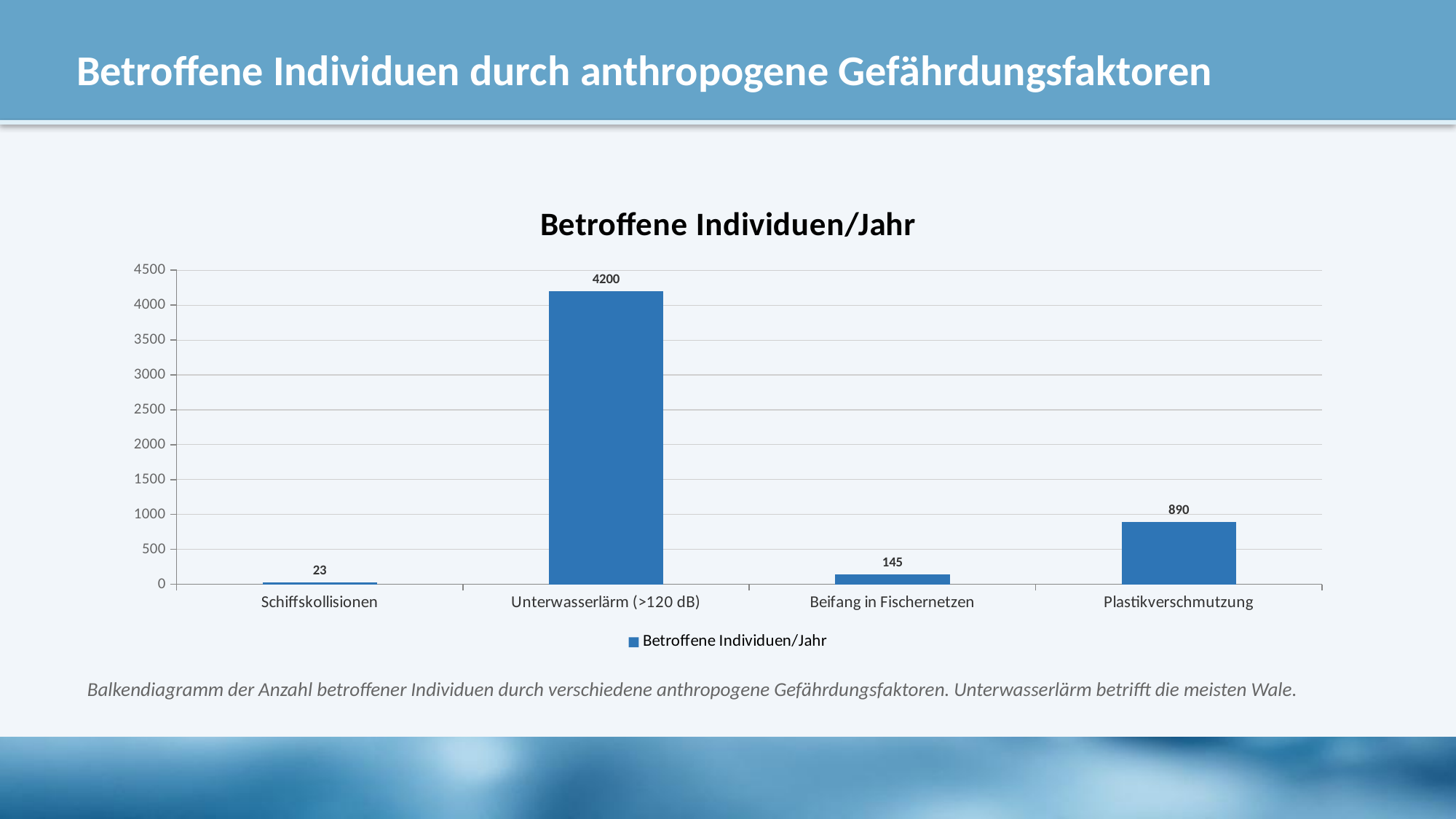
What kind of chart is shown on the slide? Bar chart Which is larger, the value for Plastikverschmutzung or the value for Beifang in Fischernetzen? Plastikverschmutzung Which category has the highest value? Unterwasserlärm (>120 dB) How many categories are shown on the x axis? 4 What is the value for Unterwasserlärm (>120 dB)? 4200 Which category has the lowest value? Schiffskollisionen What is the title of the chart? Betroffene Individuen/Jahr What is the value for Plastikverschmutzung? 890 What is the value for Beifang in Fischernetzen? 145 What is the difference between the values for Beifang in Fischernetzen and Schiffskollisionen? 122 What is the difference between the values for Unterwasserlärm (>120 dB) and Plastikverschmutzung? 3310 What is the value for Schiffskollisionen? 23